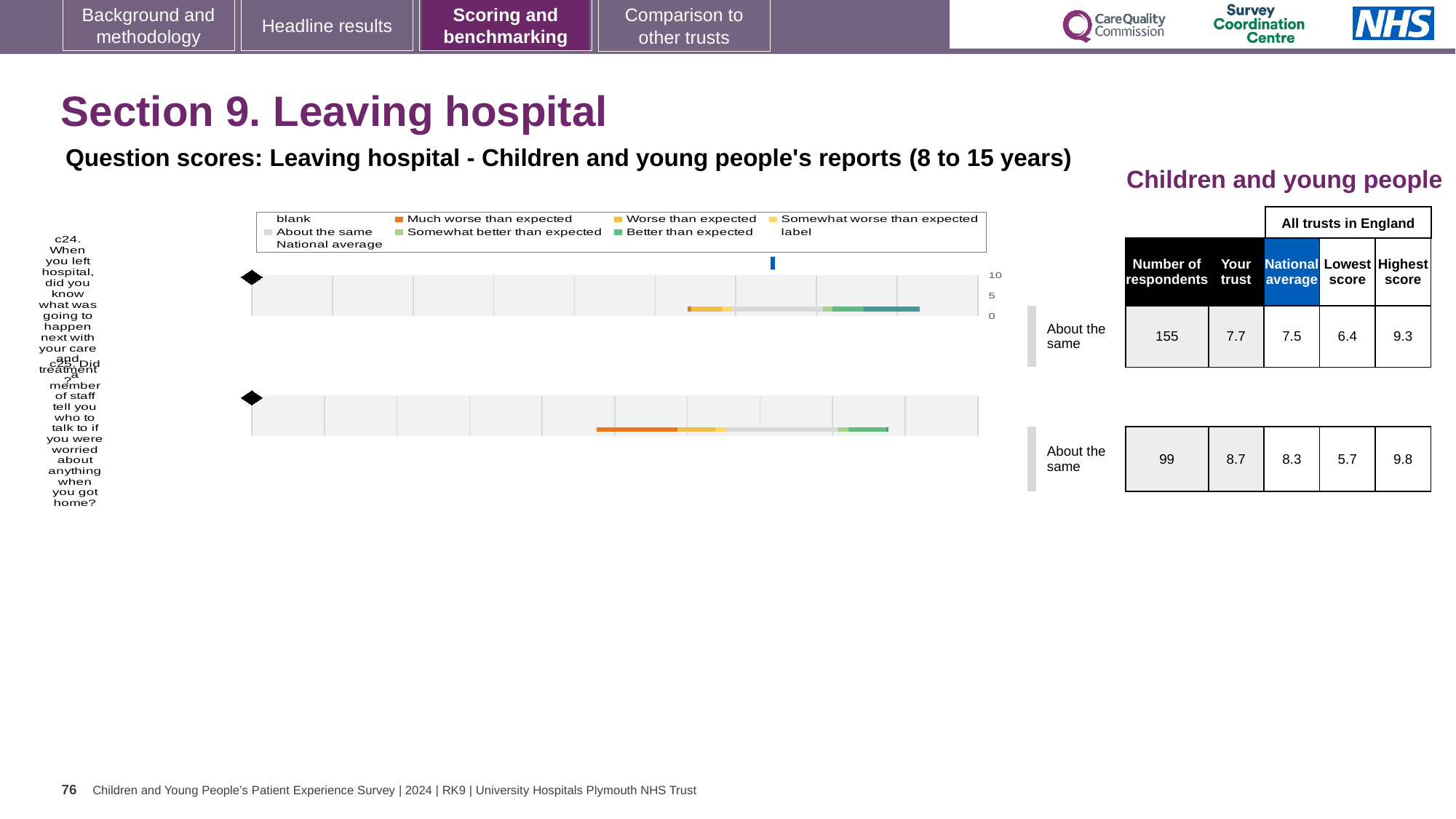
How many respondents answered question c25? 99 For question c24, is the 'Your trust' score higher or lower than the national average? Higher For question c24, what is the highest score among all trusts in England? 9.3 For question c25 (Did a member of staff tell you who to talk to if you were worried about anything when you got home?), what is the 'Your trust' score? 8.7 For question c25, what is the difference between the 'Your trust' score and the national average? 0.4 How many questions are plotted in the charts on this slide? 2 For question c24 (When you left hospital, did you know what was going to happen next with your care and treatment?), what is the 'Your trust' score? 7.7 For question c25, what is the lowest score among all trusts in England? 5.7 Which question has the higher 'Your trust' score, c24 or c25? c25 What benchmark category is shown for question c24? About the same For question c24, what is the national average score? 7.5 For question c24, what is the difference between the highest and lowest scores among all trusts in England? 2.9